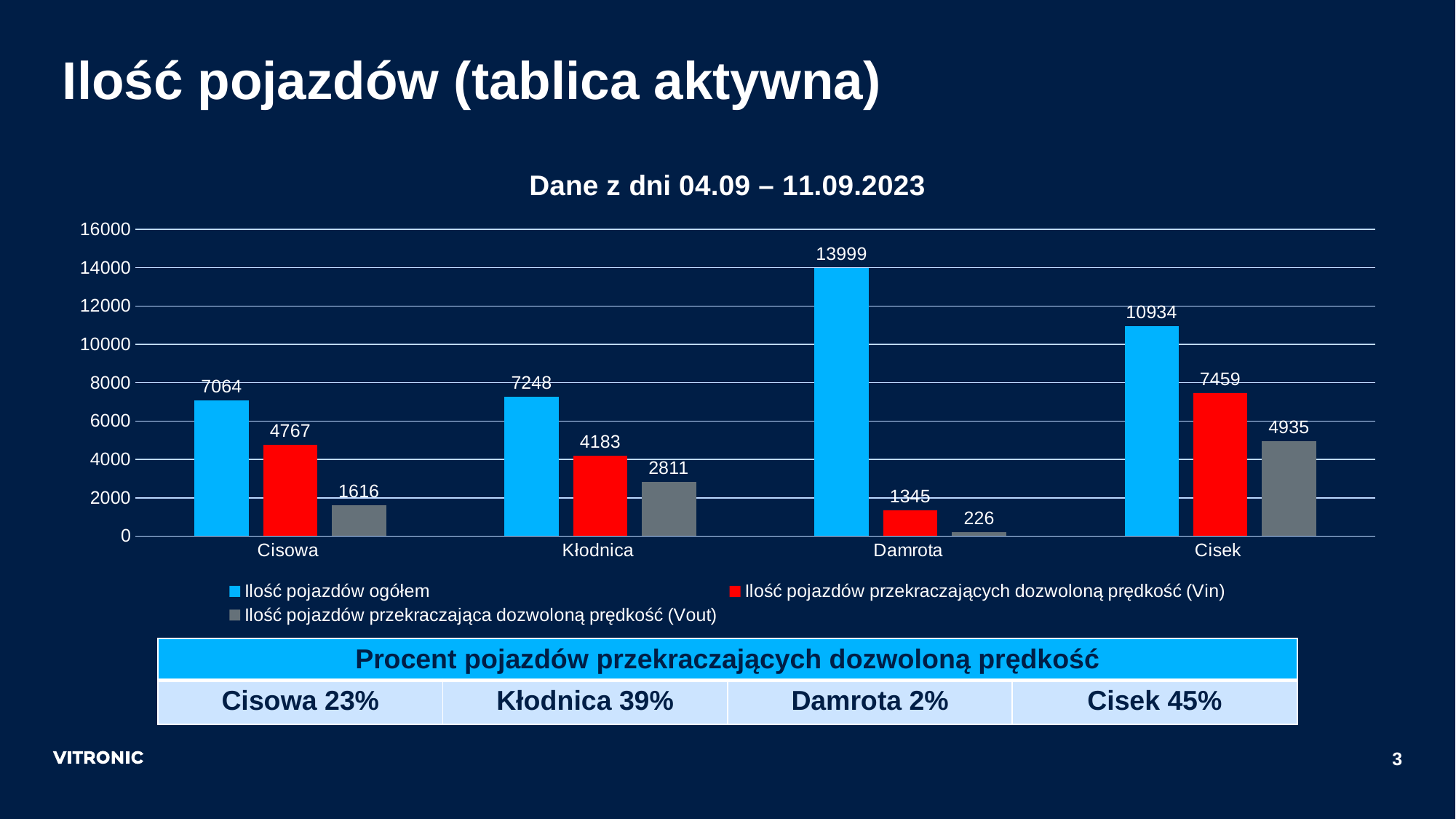
What is the value of 'Ilość pojazdów przekraczająca dozwoloną prędkość (Vout)' for Kłodnica? 2811 What is the difference between 'Ilość pojazdów ogółem' for Cisek and for Cisowa? 3870 Which location has the highest value for 'Ilość pojazdów ogółem'? Damrota Which is larger: the Vin value for Cisowa or the Vin value for Kłodnica? Cisowa What is the title shown above the chart? Dane z dni 04.09 – 11.09.2023 What type of chart is shown on the slide? bar chart Which location has the lowest value for 'Ilość pojazdów przekraczająca dozwoloną prędkość (Vout)'? Damrota Is the value of 'Ilość pojazdów ogółem' for Kłodnica greater or less than 8000? less How many locations are shown on the x axis of the chart? 4 What is the value of 'Ilość pojazdów ogółem' for Damrota? 13999 What is the value of 'Ilość pojazdów przekraczających dozwoloną prędkość (Vin)' for Cisek? 7459 How many series does the chart legend list? 3